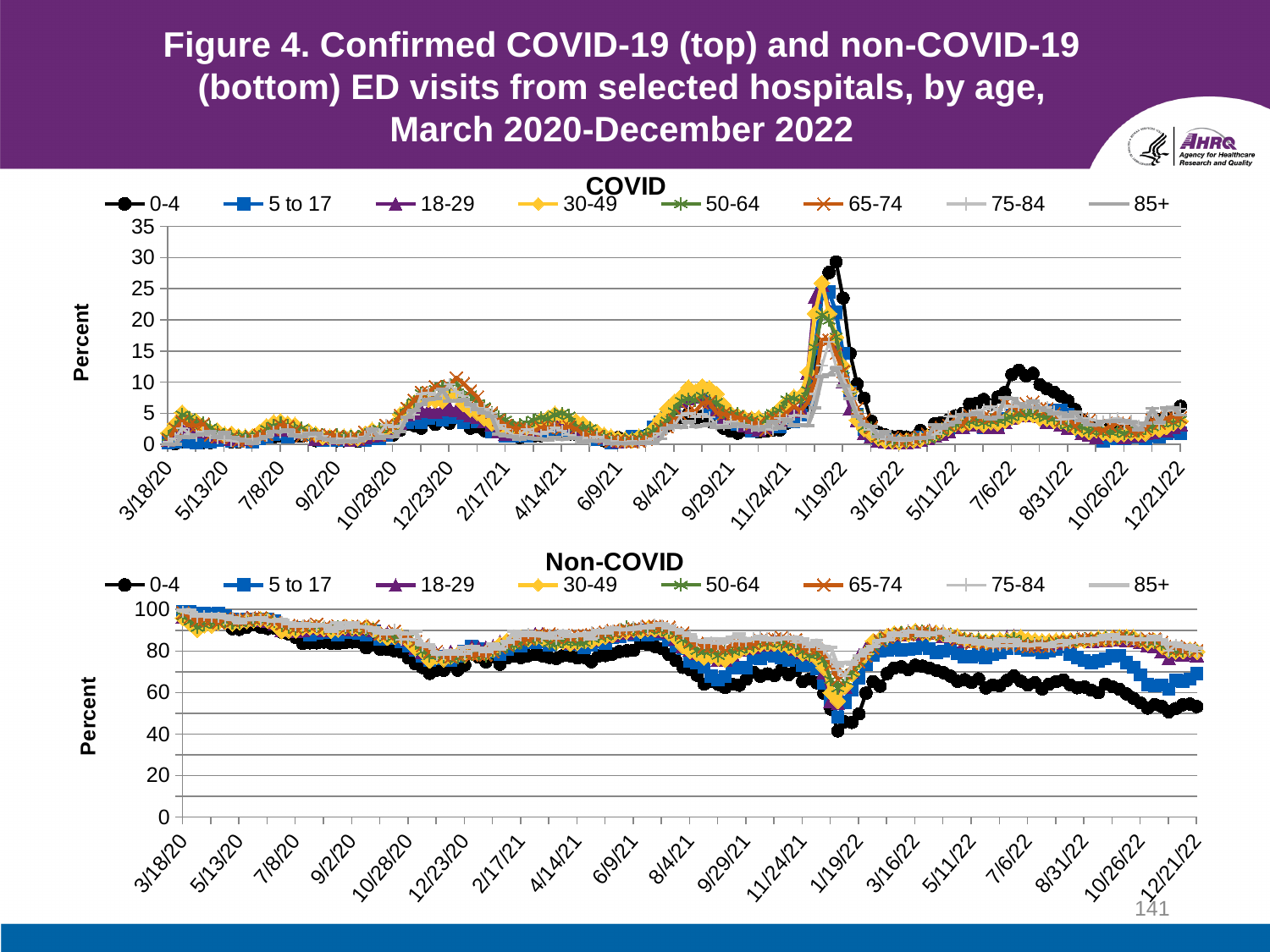
What is the y-axis label on the COVID chart? Percent What kind of chart is the top chart titled COVID? line chart In the Non-COVID chart, is the lowest value for the 0-4 series around 1/19/22 greater or less than 60? less In the Non-COVID chart, does the 0-4 series generally rise or fall from 3/18/20 to 12/21/22? fall What is the title of the bottom chart? Non-COVID In the Non-COVID chart, is the value for the 0-4 series at 12/21/22 greater or less than 60? less In the COVID chart, which age group reaches the highest peak around 1/19/22? 0-4 How many series does the legend of the COVID chart list? 8 In the COVID chart, is the value for the 0-4 series around 7/6/22 greater or less than 10? greater In the Non-COVID chart, which series is lowest at 12/21/22, 0-4 or 30-49? 0-4 How many series does the legend of the Non-COVID chart list? 8